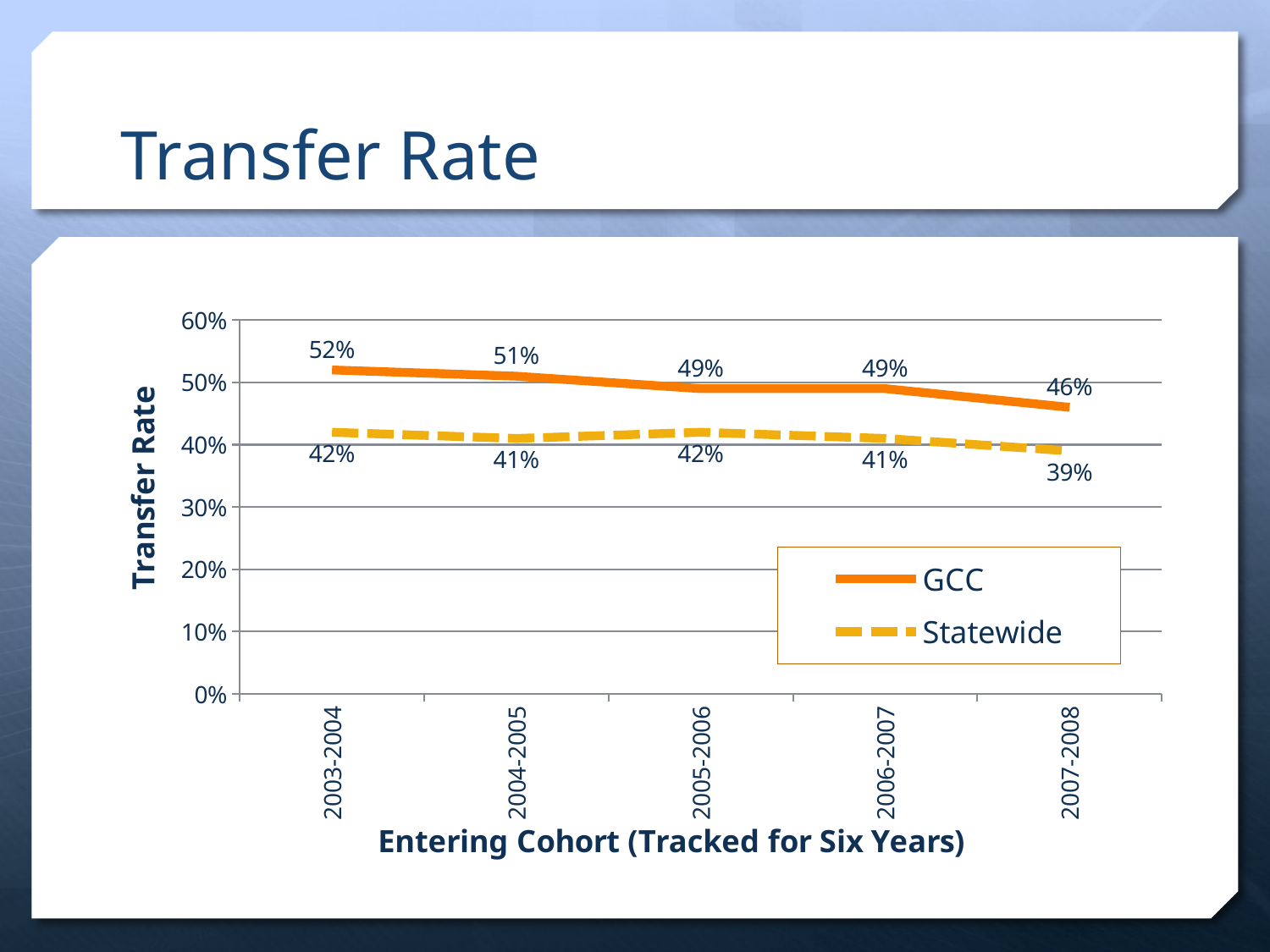
Which entering cohort has the highest GCC transfer rate? 2003-2004 What is the GCC transfer rate for the 2003-2004 entering cohort? 52% Does the GCC transfer rate rise or fall from the 2003-2004 cohort to the 2007-2008 cohort? Fall What is the difference between the GCC and Statewide transfer rates for the 2003-2004 cohort? 10% Which series has the higher transfer rate for the 2006-2007 cohort, GCC or Statewide? GCC How many series does the legend list? 2 What is the Statewide transfer rate for the 2007-2008 entering cohort? 39% What is the GCC transfer rate for the 2005-2006 entering cohort? 49% What kind of chart is shown on the slide? Line chart How many entering cohorts are shown on the x axis? 5 What is the label of the x axis? Entering Cohort (Tracked for Six Years) Which entering cohort has the lowest Statewide transfer rate? 2007-2008